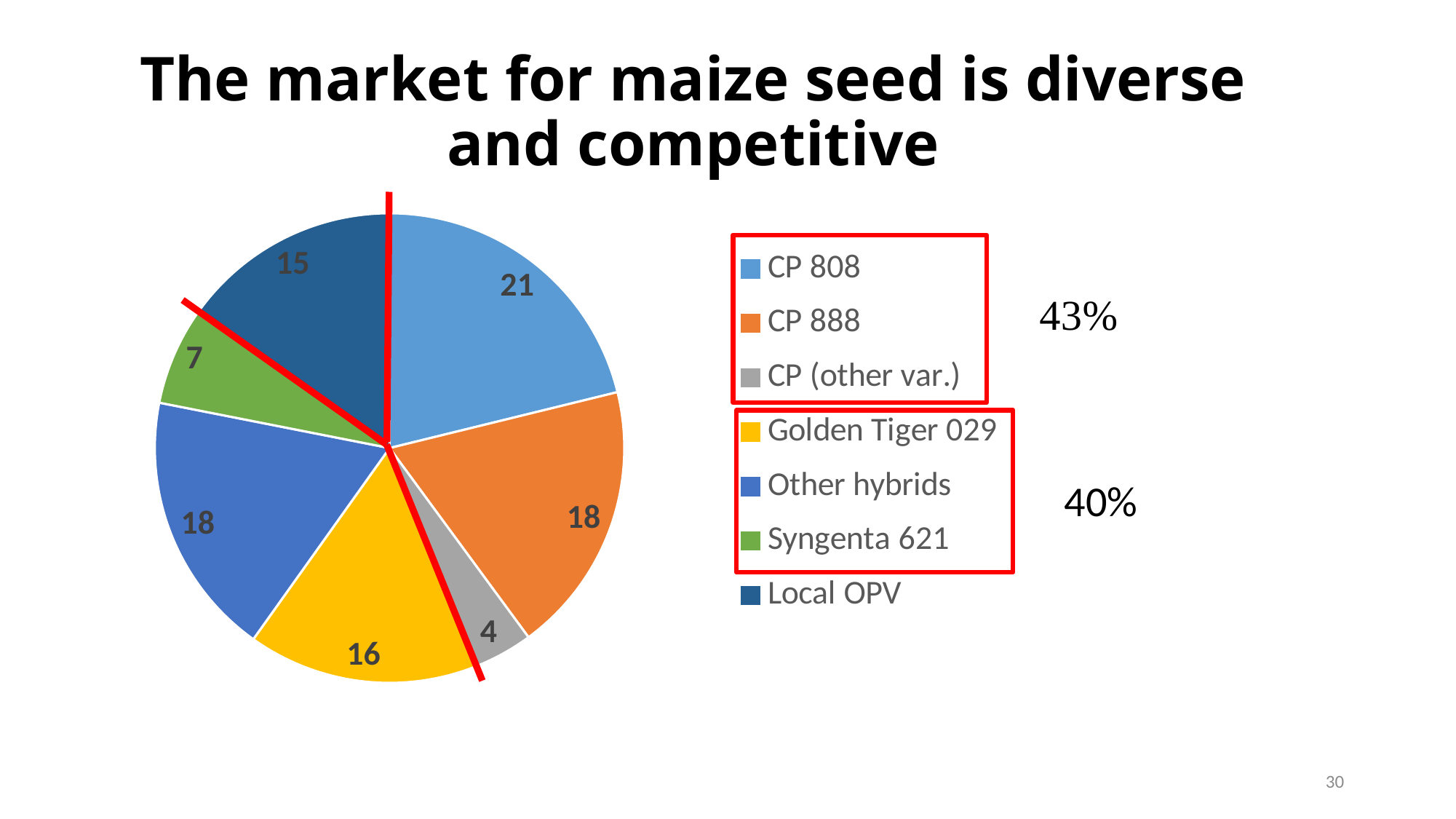
What is the difference between the values for CP 808 and Local OPV? 6 Which category has the largest slice of the pie? CP 808 What is the value shown for the CP 808 slice? 21 Which category has the smallest slice of the pie? CP (other var.) What is the value shown for the Golden Tiger 029 slice? 16 How many slices does the pie chart have? 7 What is the difference between the values for CP 888 and CP (other var.)? 14 What percentage is written next to the red box grouping CP 808, CP 888 and CP (other var.) in the legend? 43% What kind of chart is shown on the slide? pie chart Which is larger, the value for Golden Tiger 029 or the value for Syngenta 621? Golden Tiger 029 What is the value shown for the Syngenta 621 slice? 7 What is the value shown for the Local OPV slice? 15